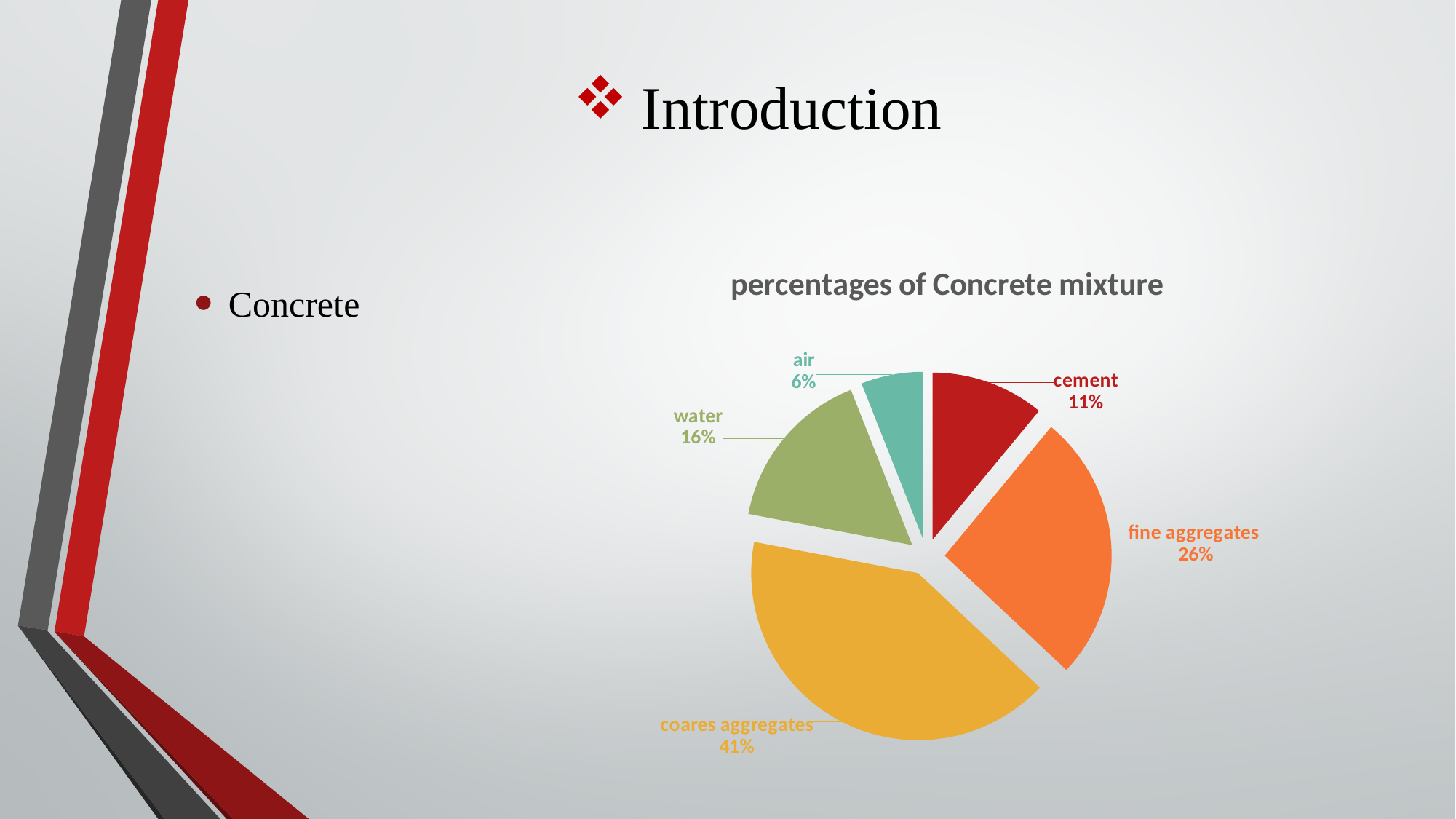
Which component has the smallest share of the concrete mixture? air What is the title of the chart? percentages of Concrete mixture Which component has the largest share of the concrete mixture? coares aggregates How many slices does the pie chart have? 5 What percentage of the concrete mixture is water? 16% Which is larger, the share for water or the share for cement? water What percentage of the concrete mixture is fine aggregates? 26% What percentage of the concrete mixture is air? 6% What percentage of the concrete mixture is cement? 11% What type of chart is shown on the slide? pie chart What is the difference in percentage between coares aggregates and fine aggregates? 15% What colour is the slice for coares aggregates? yellow-orange